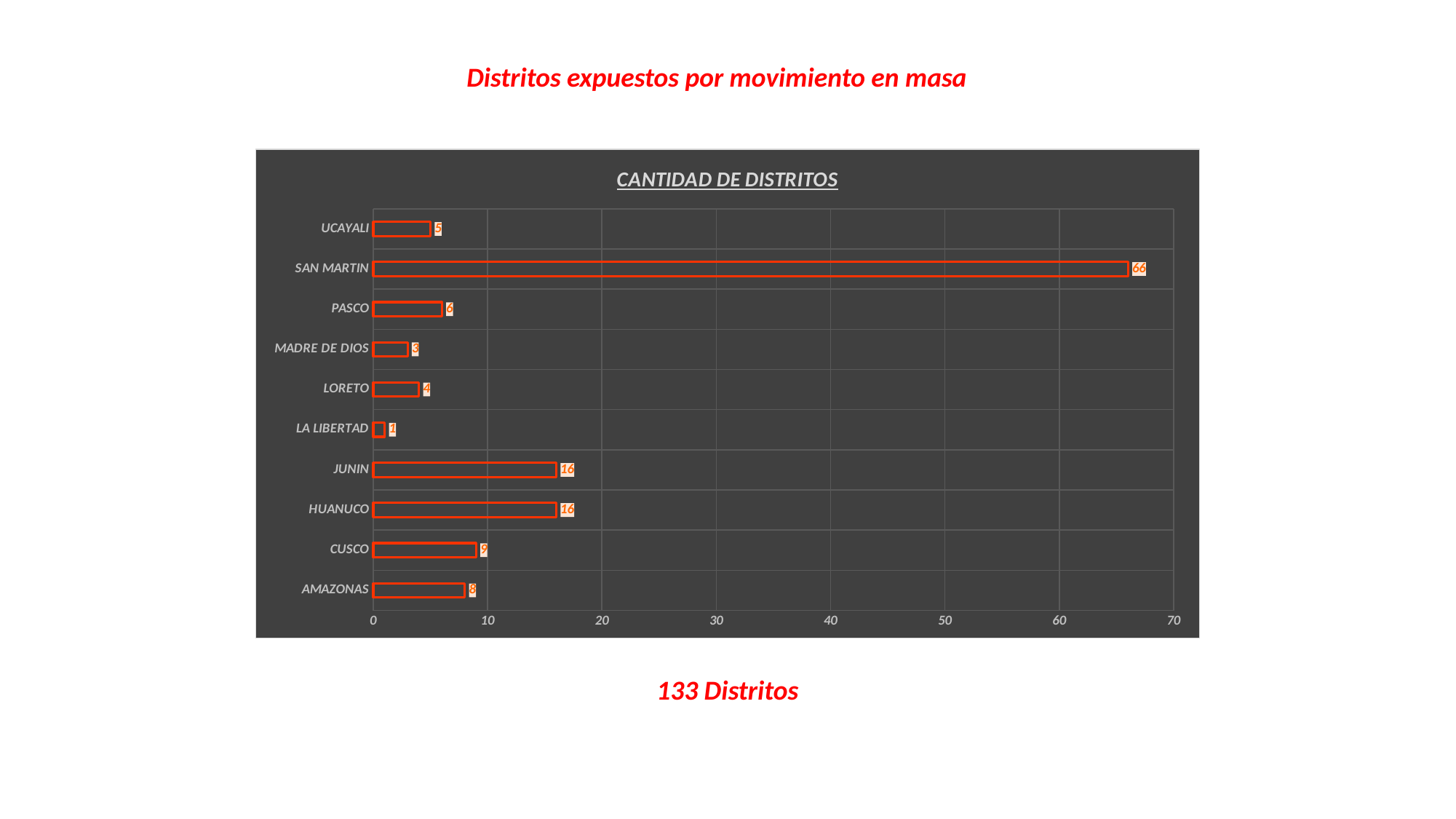
Is the value for HUANUCO greater or less than 10? greater What is the value for CUSCO? 9 What is the difference between the values for SAN MARTIN and JUNIN? 50 Which category has the lowest value? LA LIBERTAD What kind of chart is shown? Bar chart What is the value for SAN MARTIN? 66 What is the difference between the values for AMAZONAS and LORETO? 4 Which is larger, the value for PASCO or the value for UCAYALI? PASCO Which category has the highest value? SAN MARTIN How many categories are shown on the chart? 10 What is the value for MADRE DE DIOS? 3 What is the title of the chart? CANTIDAD DE DISTRITOS